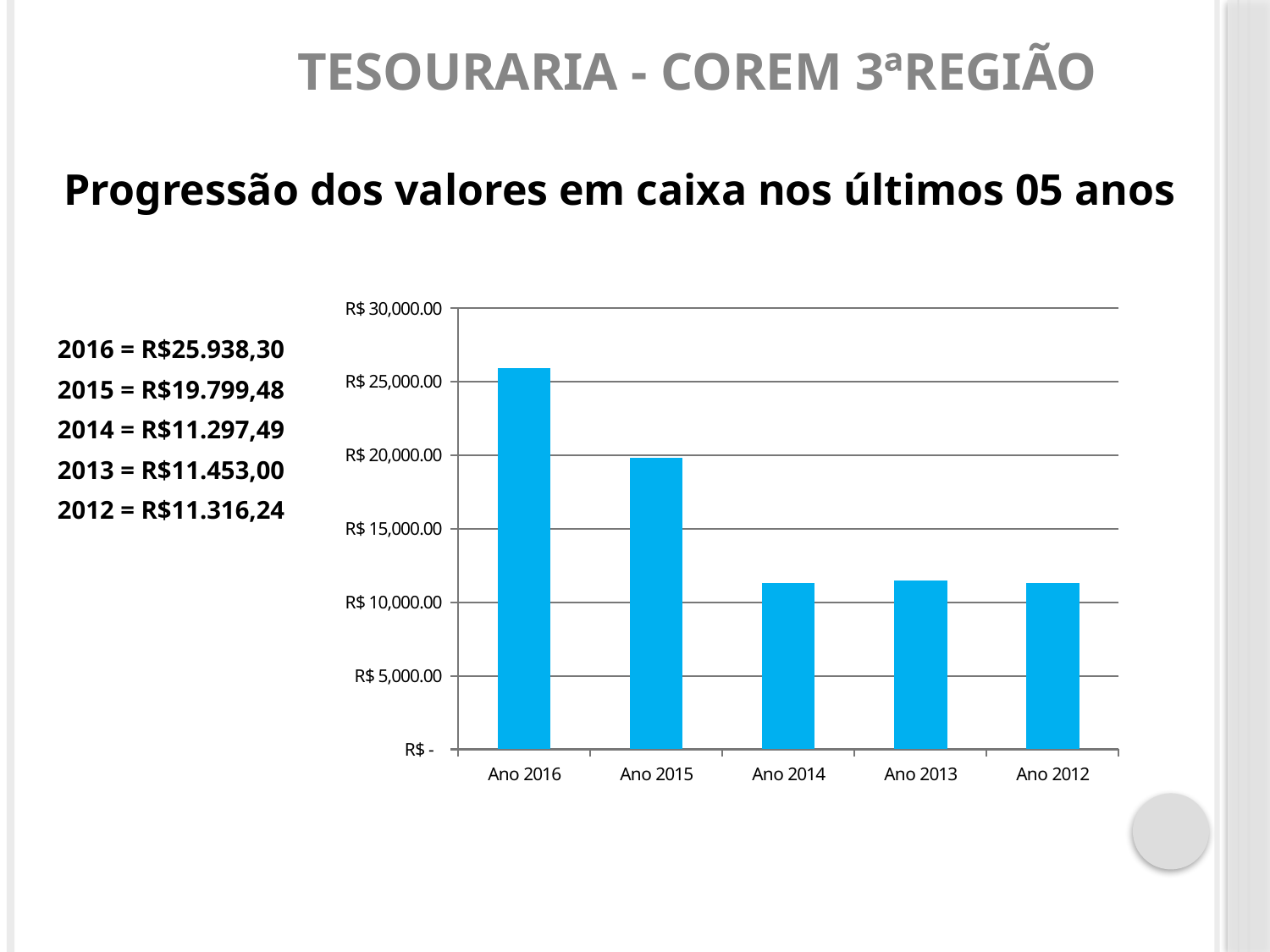
What is the value for 2016 according to the slide? R$25.938,30 What is the highest value shown on the vertical axis of the chart? R$ 30,000.00 What kind of chart is shown on the slide? bar chart What is the value for 2015 according to the slide? R$19.799,48 What is the value for 2013 according to the slide? R$11.453,00 How many years (bars) are shown in the chart? 5 What is the difference between the values for 2016 and 2015? R$6.138,82 Which year has the highest value in the chart? Ano 2016 Is the value for Ano 2015 greater or less than R$ 15,000.00? greater Is the value for Ano 2014 greater or less than R$ 15,000.00? less Which is larger, the value for Ano 2015 or the value for Ano 2014? Ano 2015